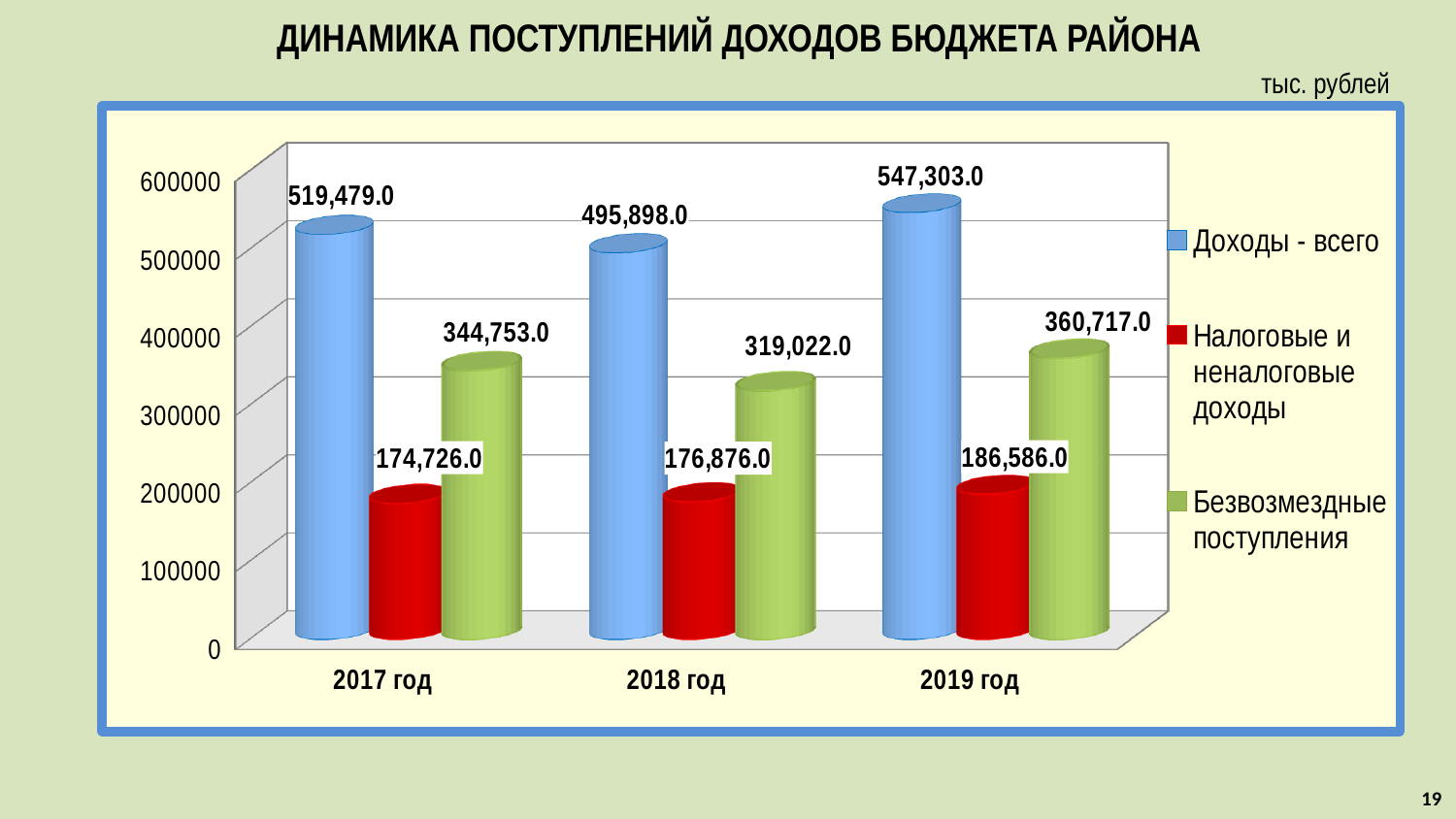
What is the value for Безвозмездные поступления in 2019 год? 360,717.0 In which year is Доходы - всего the highest? 2019 год Which is larger in 2017 год: Налоговые и неналоговые доходы or Безвозмездные поступления? Безвозмездные поступления What kind of chart is shown on the slide? bar chart How many years are shown on the x axis? 3 Is the value for Доходы - всего in 2018 год greater or less than 500000? less What is the value for Доходы - всего in 2017 год? 519,479.0 What is the difference between Безвозмездные поступления in 2019 год and in 2018 год? 41,695.0 What is the difference between Доходы - всего in 2019 год and in 2017 год? 27,824.0 What is the value for Налоговые и неналоговые доходы in 2018 год? 176,876.0 In which year is Безвозмездные поступления the lowest? 2018 год How many series does the legend list? 3